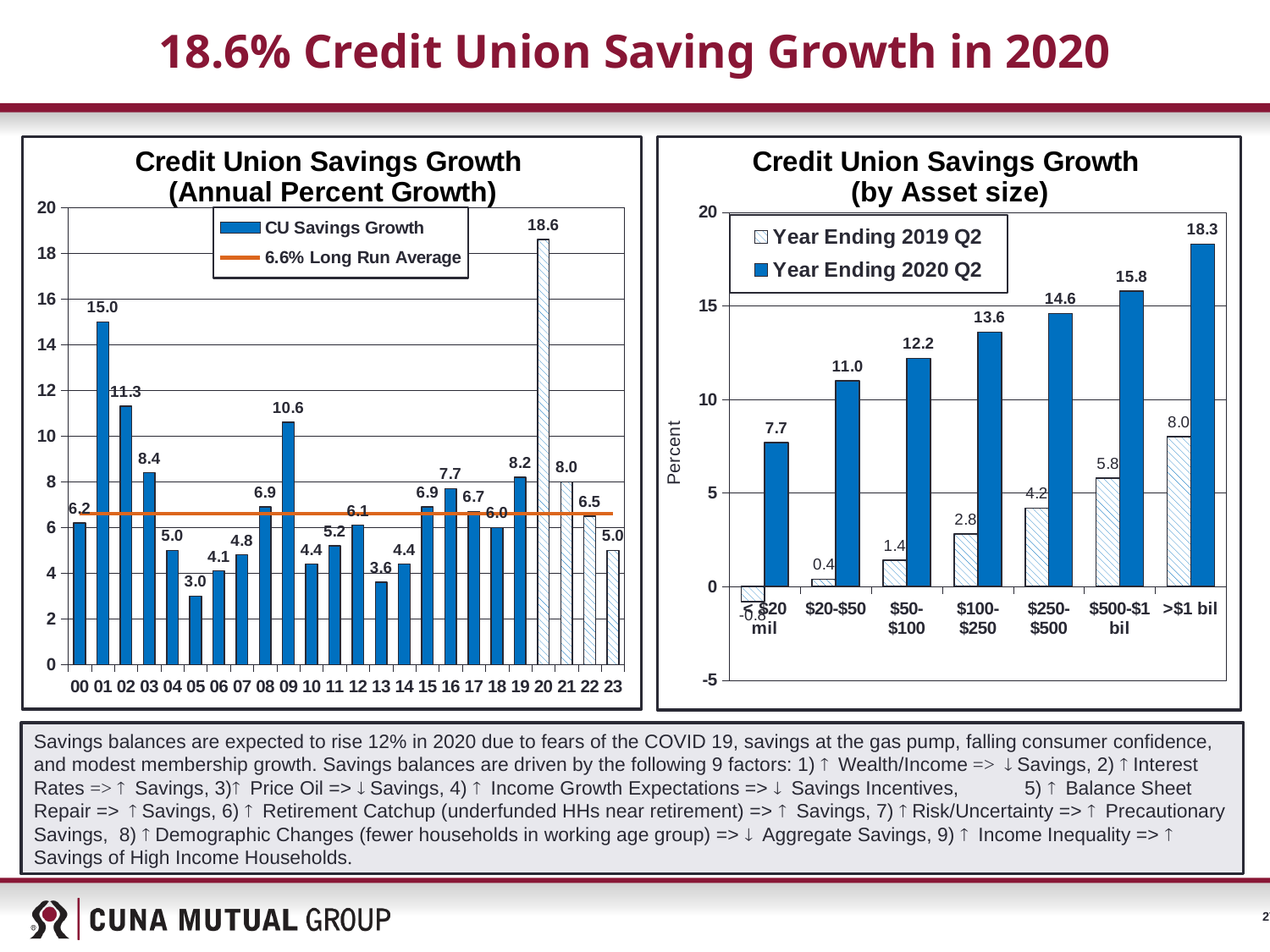
In the 'Credit Union Savings Growth (Annual Percent Growth)' chart, what long run average does the legend give for the horizontal line? 6.6% In the 'Credit Union Savings Growth (Annual Percent Growth)' chart, what is the CU Savings Growth value for 2020? 18.6 In the 'Credit Union Savings Growth (Annual Percent Growth)' chart, how many years are shown on the x axis? 24 In the 'Credit Union Savings Growth (Annual Percent Growth)' chart, which year has the lowest CU Savings Growth value? 05 In the 'Credit Union Savings Growth (by Asset size)' chart, how many series does the legend list? 2 What kind of chart is the 'Credit Union Savings Growth (by Asset size)' chart? bar chart In the 'Credit Union Savings Growth (Annual Percent Growth)' chart, what is the difference between the 2020 value and the 2019 value? 10.4 In the 'Credit Union Savings Growth (Annual Percent Growth)' chart, which is larger, the value for 2001 or the value for 2009? 2001 In the 'Credit Union Savings Growth (by Asset size)' chart, what is the difference between the Year Ending 2020 Q2 and Year Ending 2019 Q2 values for the $100-$250 asset group? 10.8 In the 'Credit Union Savings Growth (by Asset size)' chart, what is the Year Ending 2019 Q2 value for the <$20 mil asset group? -0.8 In the 'Credit Union Savings Growth (by Asset size)' chart, do the Year Ending 2020 Q2 values rise or fall as asset size increases from left to right? rise In the 'Credit Union Savings Growth (by Asset size)' chart, what is the Year Ending 2020 Q2 value for the >$1 bil asset group? 18.3